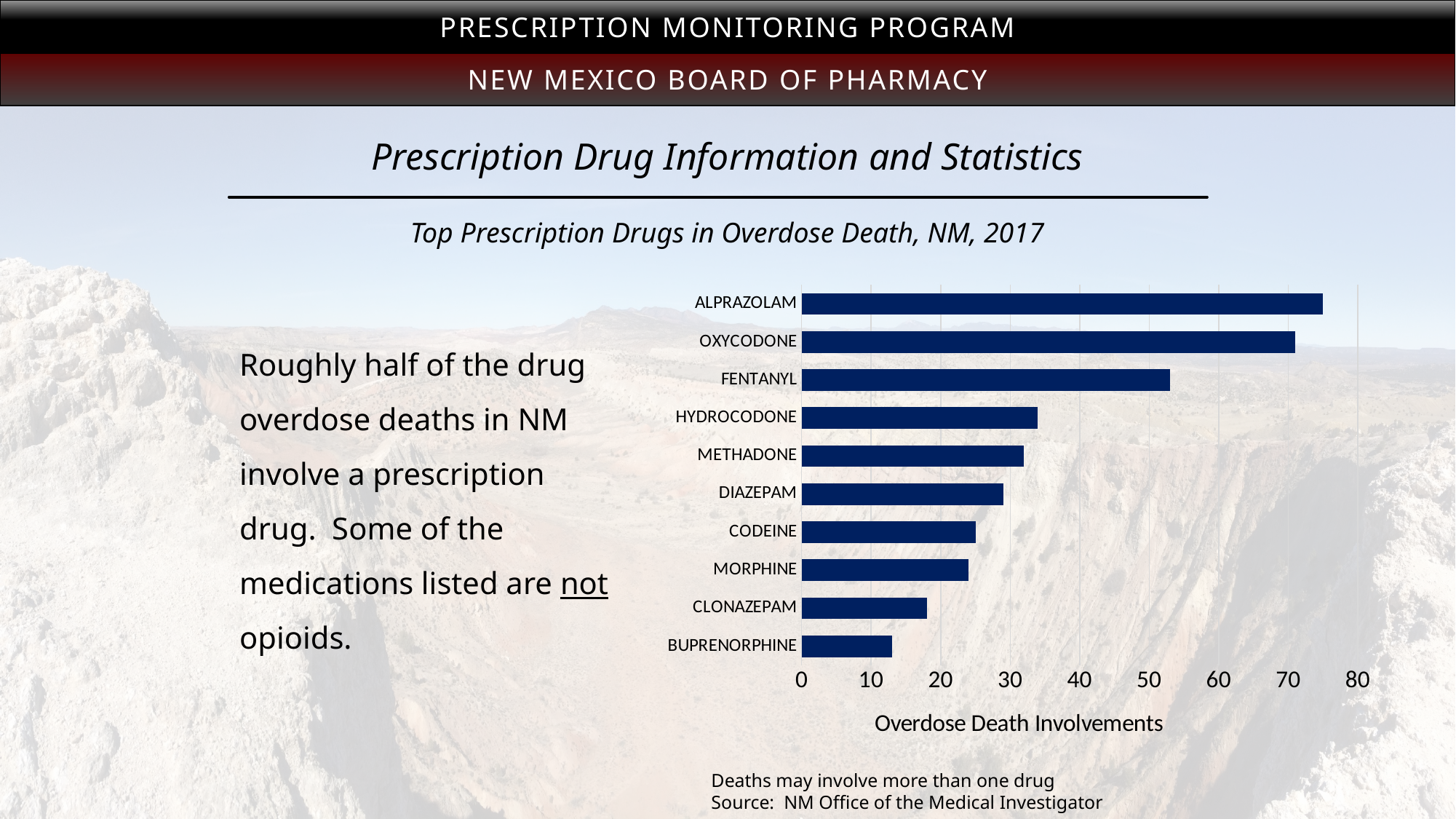
Is the value for HYDROCODONE greater or less than 40? less Is the value for FENTANYL greater or less than 50? greater Is the value for BUPRENORPHINE greater or less than 10? greater What is the label on the horizontal axis of the chart? Overdose Death Involvements Which has more overdose death involvements, DIAZEPAM or CLONAZEPAM? DIAZEPAM What kind of chart is shown on the slide? bar chart How many drugs are listed in the chart? 10 Which has more overdose death involvements, FENTANYL or HYDROCODONE? FENTANYL Which drug has the highest number of overdose death involvements? ALPRAZOLAM Which drug has the lowest number of overdose death involvements? BUPRENORPHINE